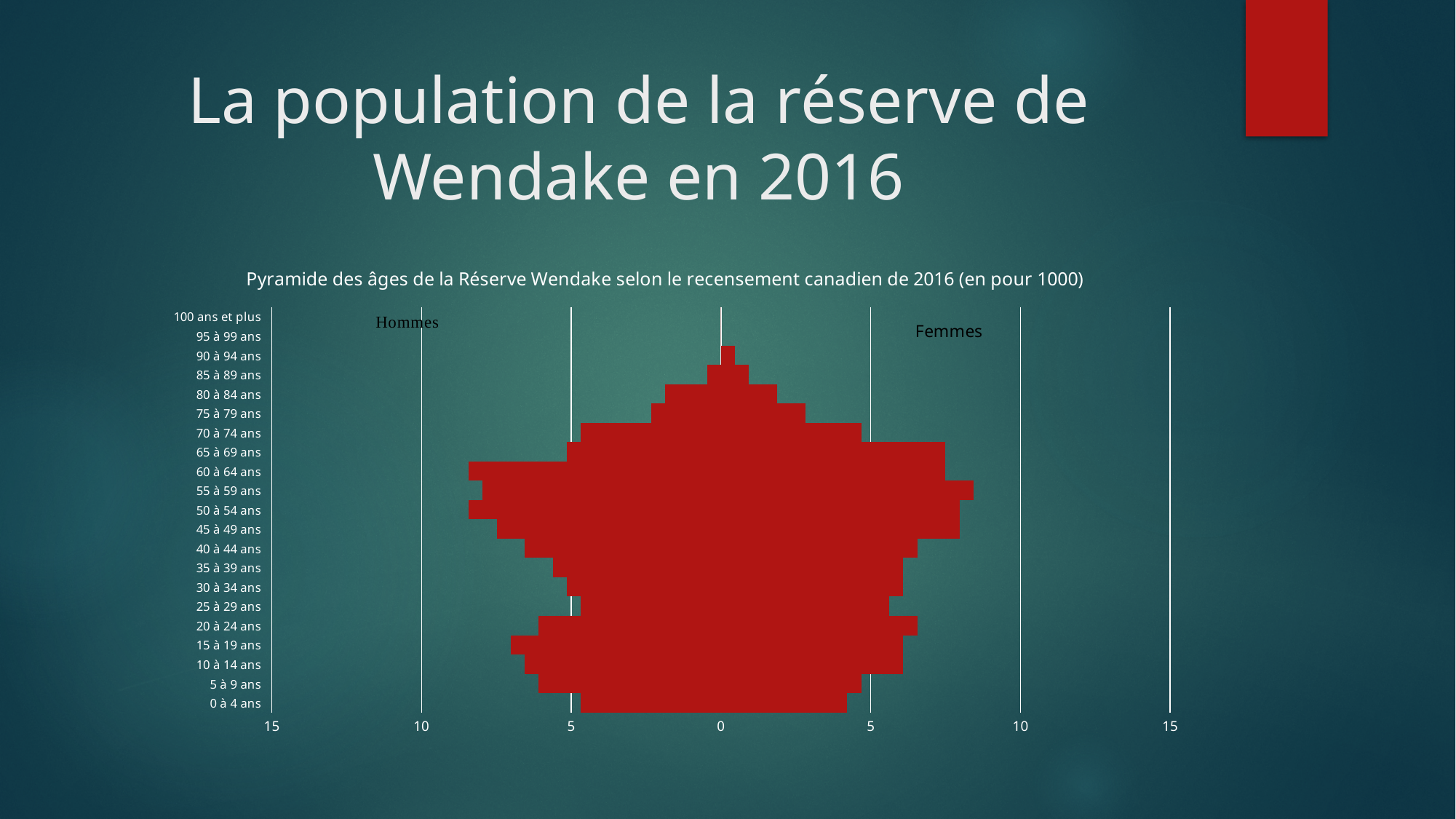
Is the Femmes value for 55 à 59 ans greater or less than 5? greater What kind of chart is shown on the slide? bar chart Which two groups are labelled on the left and right sides of the pyramid? Hommes and Femmes How many series (population groups) does the chart show? 2 For Hommes, which age group has the larger value: 0 à 4 ans or 15 à 19 ans? 15 à 19 ans Is the Femmes value for 0 à 4 ans greater or less than 5? less Is the Hommes value for 75 à 79 ans greater or less than 5? less What is the title of the chart? Pyramide des âges de la Réserve Wendake selon le recensement canadien de 2016 (en pour 1000) For Femmes, which age group has the larger value: 55 à 59 ans or 0 à 4 ans? 55 à 59 ans How many age groups are listed on the vertical axis of the chart? 21